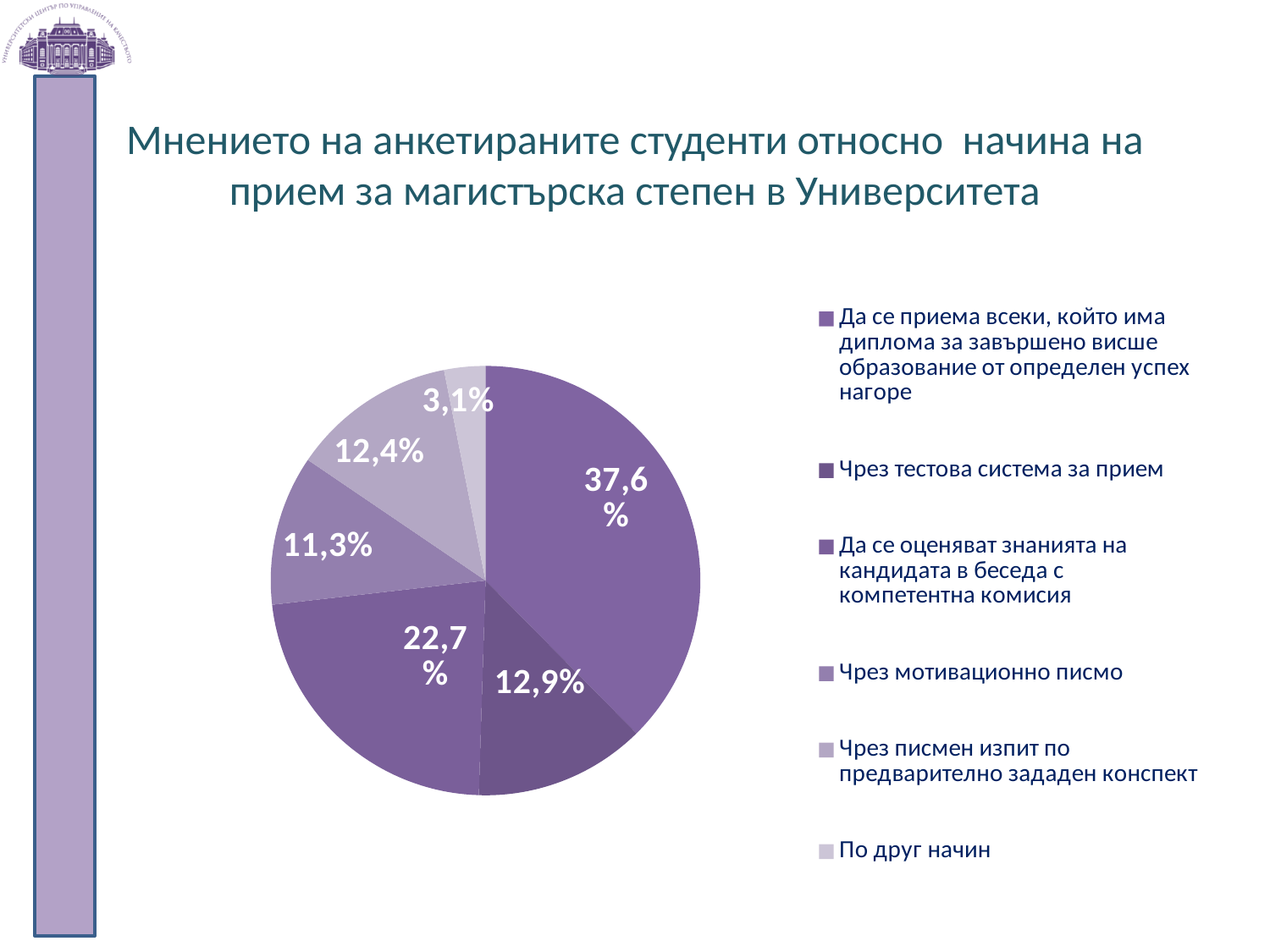
What share of respondents chose "По друг начин"? 3,1% Which option has the largest share of the pie? Да се приема всеки, който има диплома за завършено висше образование от определен успех нагоре What share of respondents chose "Да се оценяват знанията на кандидата в беседа с компетентна комисия"? 22,7% What share of respondents chose "Чрез мотивационно писмо"? 11,3% What share of respondents chose "Чрез тестова система за прием"? 12,9% What type of chart is shown on the slide? pie chart How many entries does the legend list? 6 Which is larger: the share for "Чрез писмен изпит по предварително зададен конспект" or the share for "Чрез мотивационно писмо"? Чрез писмен изпит по предварително зададен конспект What share of respondents chose "Да се приема всеки, който има диплома за завършено висше образование от определен успех нагоре"? 37,6% What is the difference in percentage points between the largest slice (37,6%) and the slice for "Да се оценяват знанията на кандидата в беседа с компетентна комисия" (22,7%)? 14,9 Which option has the smallest share of the pie? По друг начин How many slices does the pie chart have? 6